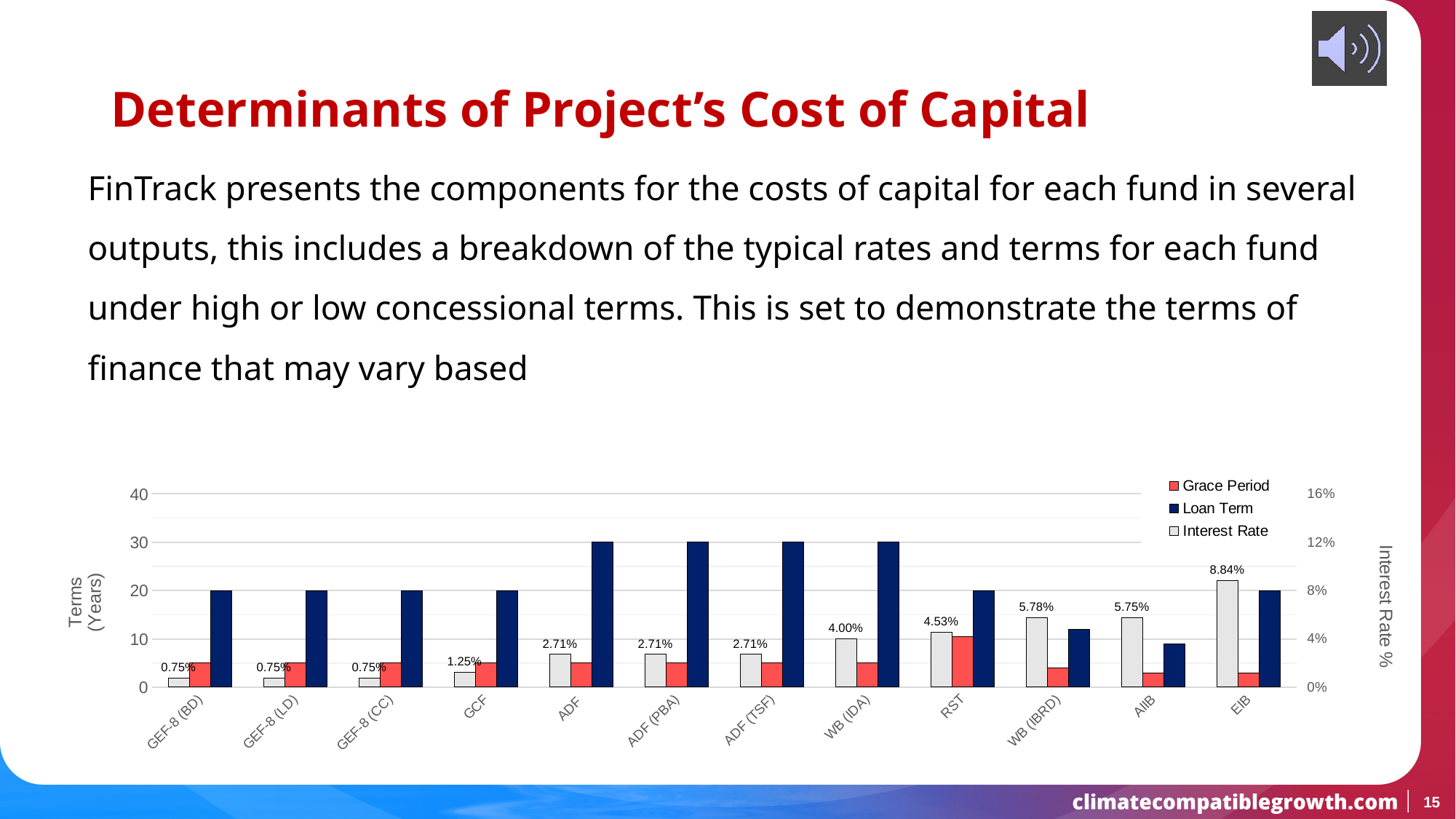
What is the Interest Rate for WB (IDA)? 4.00% What kind of chart is shown on the slide? Bar chart What is the title of the right-hand vertical axis of the chart? Interest Rate % Which fund has the highest Interest Rate? EIB Is the Loan Term for WB (IBRD) greater or less than 20 years? less What is the Loan Term in years for ADF? 30 What is the Interest Rate for EIB? 8.84% What is the Interest Rate for GCF? 1.25% How many series does the chart legend list? 3 Which has the larger Interest Rate, RST or WB (IDA)? RST What is the difference between the Interest Rate for EIB and the Interest Rate for WB (IBRD)? 3.06% How many funds (categories) are shown along the x axis of the chart? 12